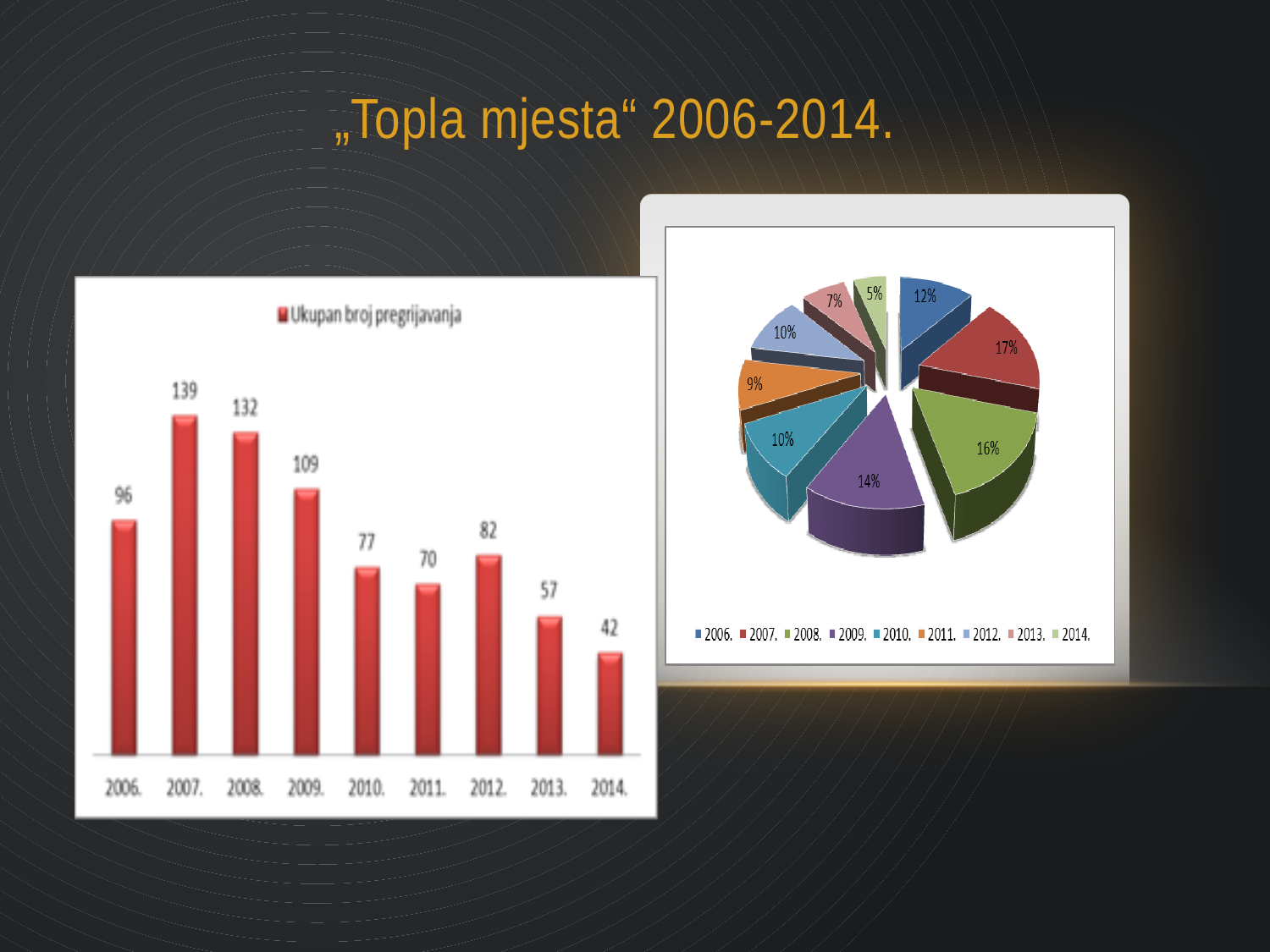
In the bar chart on the left, which year has the lowest value? 2014. How many entries does the legend of the pie chart on the right list? 9 In the bar chart on the left, what is the value for 2007? 139 In the bar chart on the left, what is the difference between the values for 2007 and 2008? 7 In the bar chart on the left, which is larger, the value for 2011 or the value for 2012? 2012. In the bar chart on the left, what is the value for 2014? 42 In the pie chart on the right, what share does 2014 have? 5% In the bar chart on the left, what is the name of the series shown in the legend? Ukupan broj pregrijavanja In the bar chart on the left, which year has the highest value? 2007. In the pie chart on the right, what share does 2007 have? 17% How many years are shown on the x axis of the bar chart on the left? 9 What kind of chart is the chart on the left? bar chart